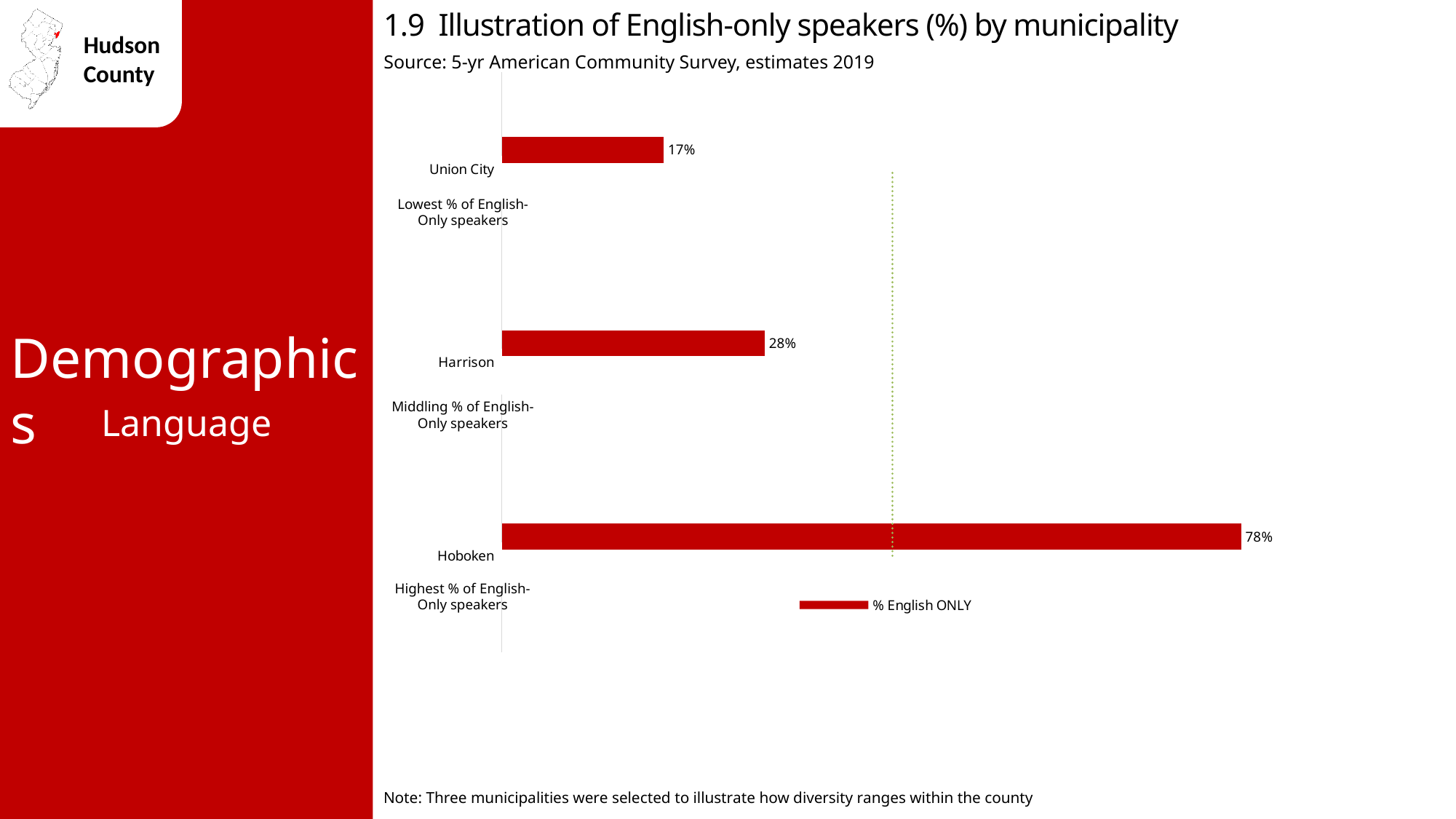
What is the value for Hoboken? 78% What is the legend entry for the series in the chart? % English ONLY Which municipality has the highest percentage of English-only speakers? Hoboken What is the difference between the values for Harrison and Union City? 11% What kind of chart is shown on the slide? Bar chart What is the value for Union City? 17% Which has a larger value, Harrison or Union City? Harrison How many series does the legend list? 1 Which municipality has the lowest percentage of English-only speakers? Union City What is the difference between the values for Hoboken and Union City? 61% How many municipalities are shown in the chart? 3 What is the value for Harrison? 28%